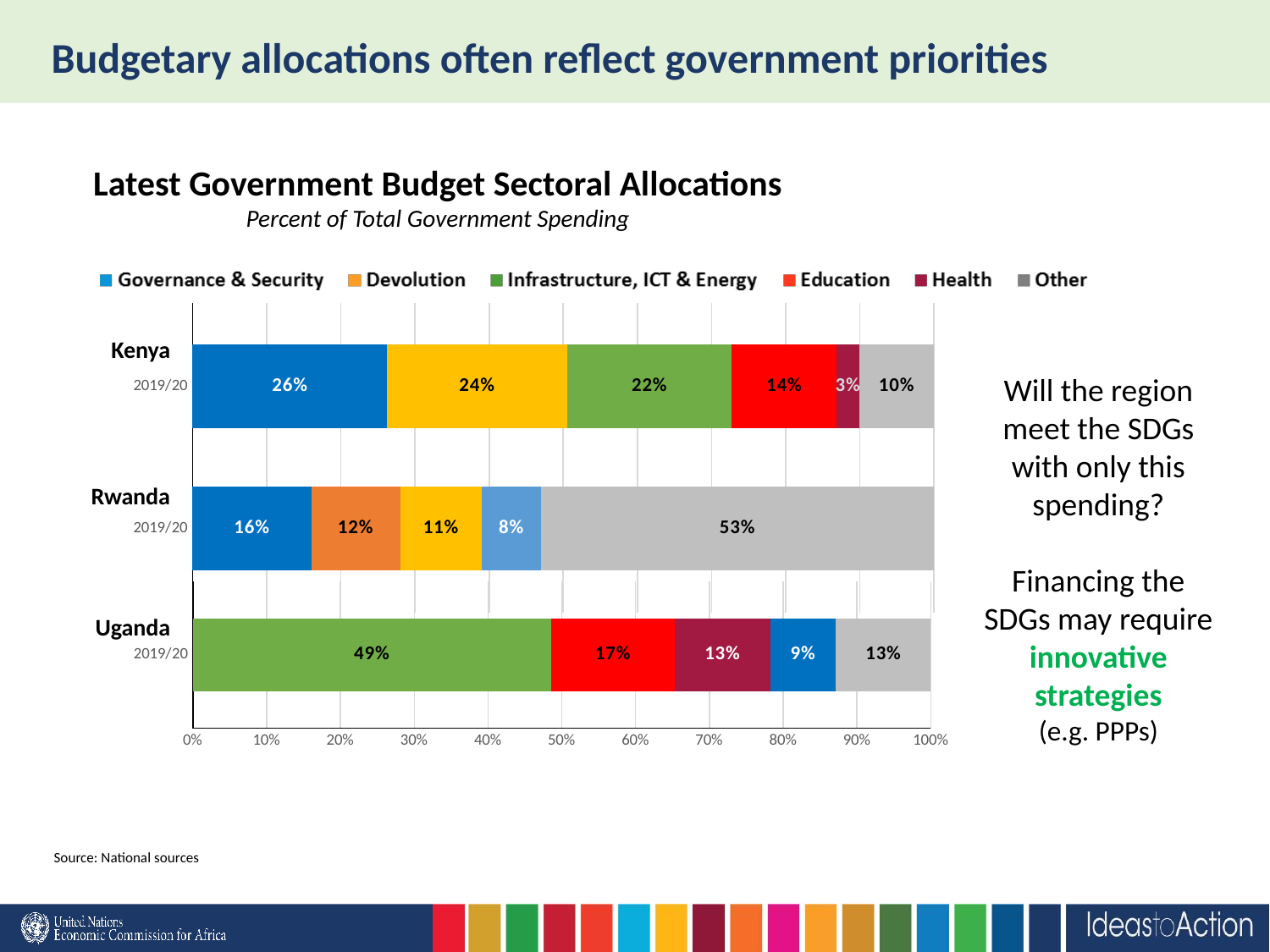
What share of Uganda's 2019/20 budget goes to Infrastructure, ICT & Energy? 49% Which sector receives the largest share of Uganda's budget? Infrastructure, ICT & Energy What is the difference in percentage points between Kenya's and Uganda's Governance & Security allocations? 17 percentage points What share of Kenya's 2019/20 budget goes to Governance & Security? 26% What share of Uganda's budget is allocated to Education? 17% What is the title of the chart? Latest Government Budget Sectoral Allocations Which country allocates a larger share to Education, Kenya or Uganda? Uganda What type of chart is shown on the slide? Stacked bar chart How many series does the legend list? 6 What share of Kenya's budget is allocated to Health? 3% What share of Rwanda's 2019/20 budget is allocated to Other? 53% How many countries are shown in the chart? 3